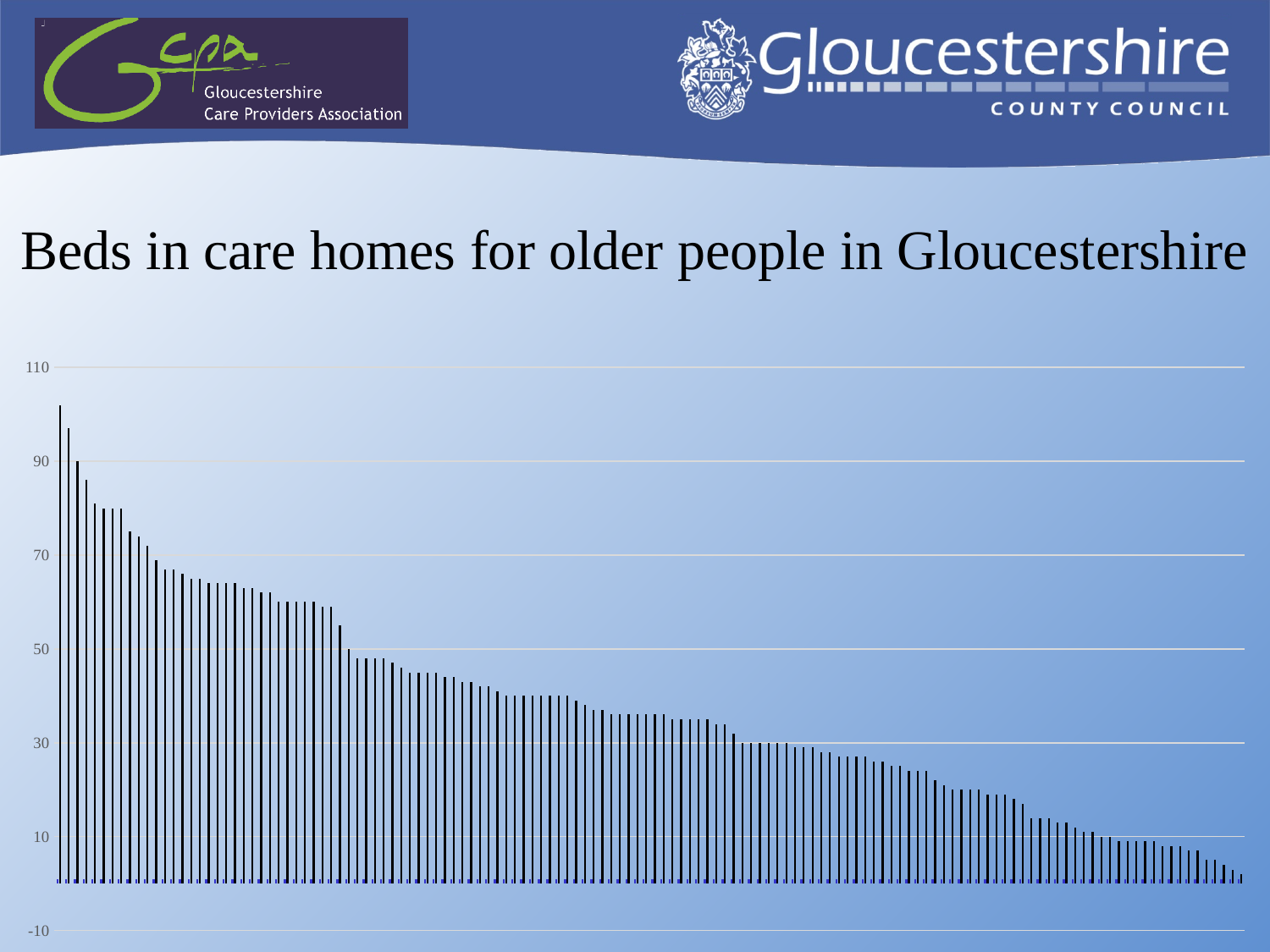
Is the value of the tallest bar greater or less than 90? greater Is the value of the tallest bar greater or less than 110? less What is the title of the chart? Beds in care homes for older people in Gloucestershire What is the highest value labelled on the vertical axis? 110 Is the value of the second bar from the left greater or less than 90? greater Are the bars in the chart arranged in ascending or descending order of value? descending Which bar is the tallest, the leftmost bar or the rightmost bar? leftmost Do the bar values rise or fall from left to right across the chart? fall What kind of chart is shown on the slide? bar chart